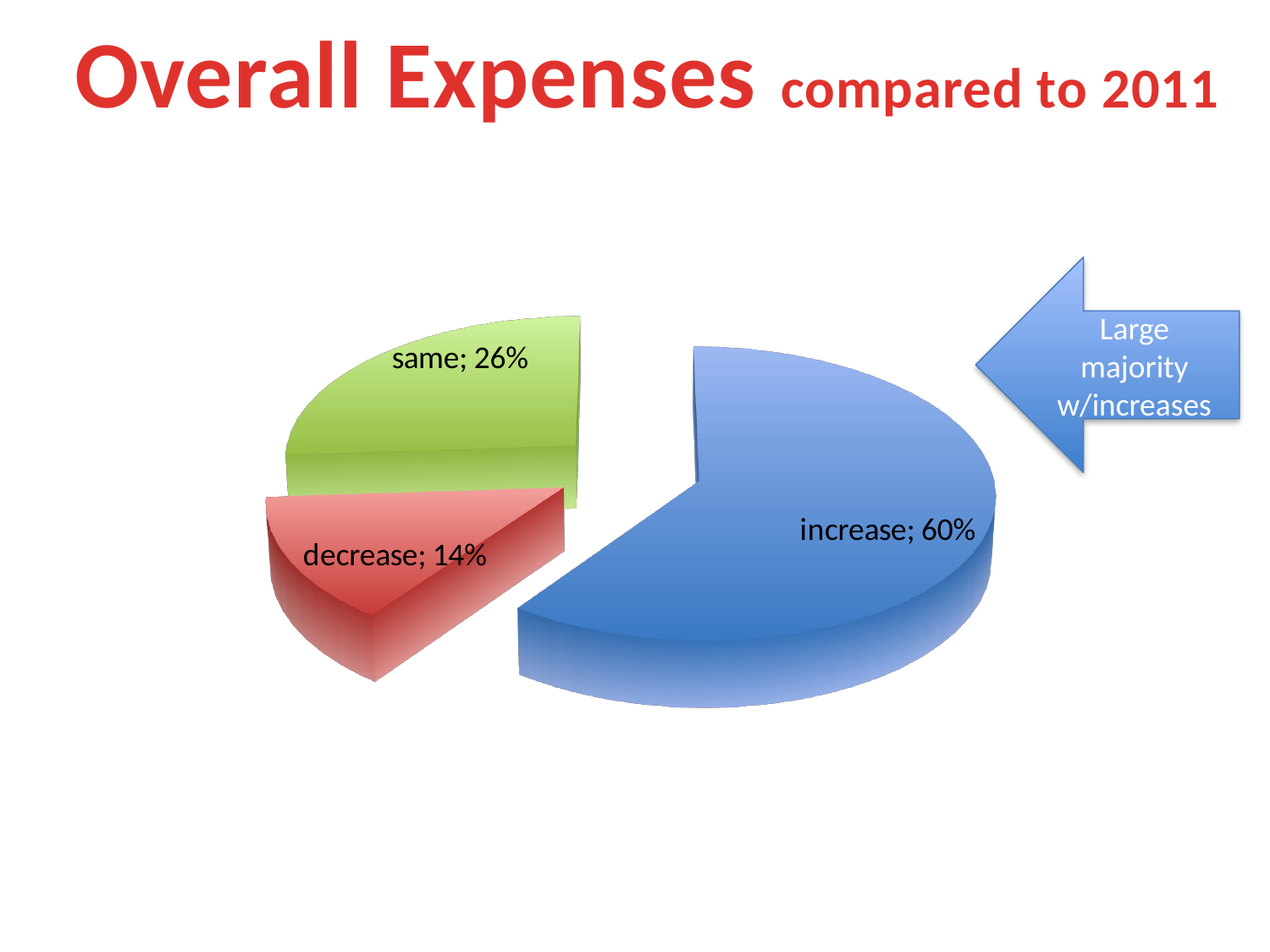
What share of the pie is labelled "increase"? 60% What share of the pie is labelled "same"? 26% How many slices does the pie chart have? 3 What is the title of the slide containing the pie chart? Overall Expenses compared to 2011 What is the difference in percentage points between the "same" and "decrease" slices? 12 Which is larger, the "same" slice or the "decrease" slice? same What share of the pie is labelled "decrease"? 14% What colour is the "increase" slice? blue Which slice of the pie is the largest? increase What is the difference in percentage points between the "increase" and "same" slices? 34 What kind of chart is shown on the slide? pie chart Which slice of the pie is the smallest? decrease